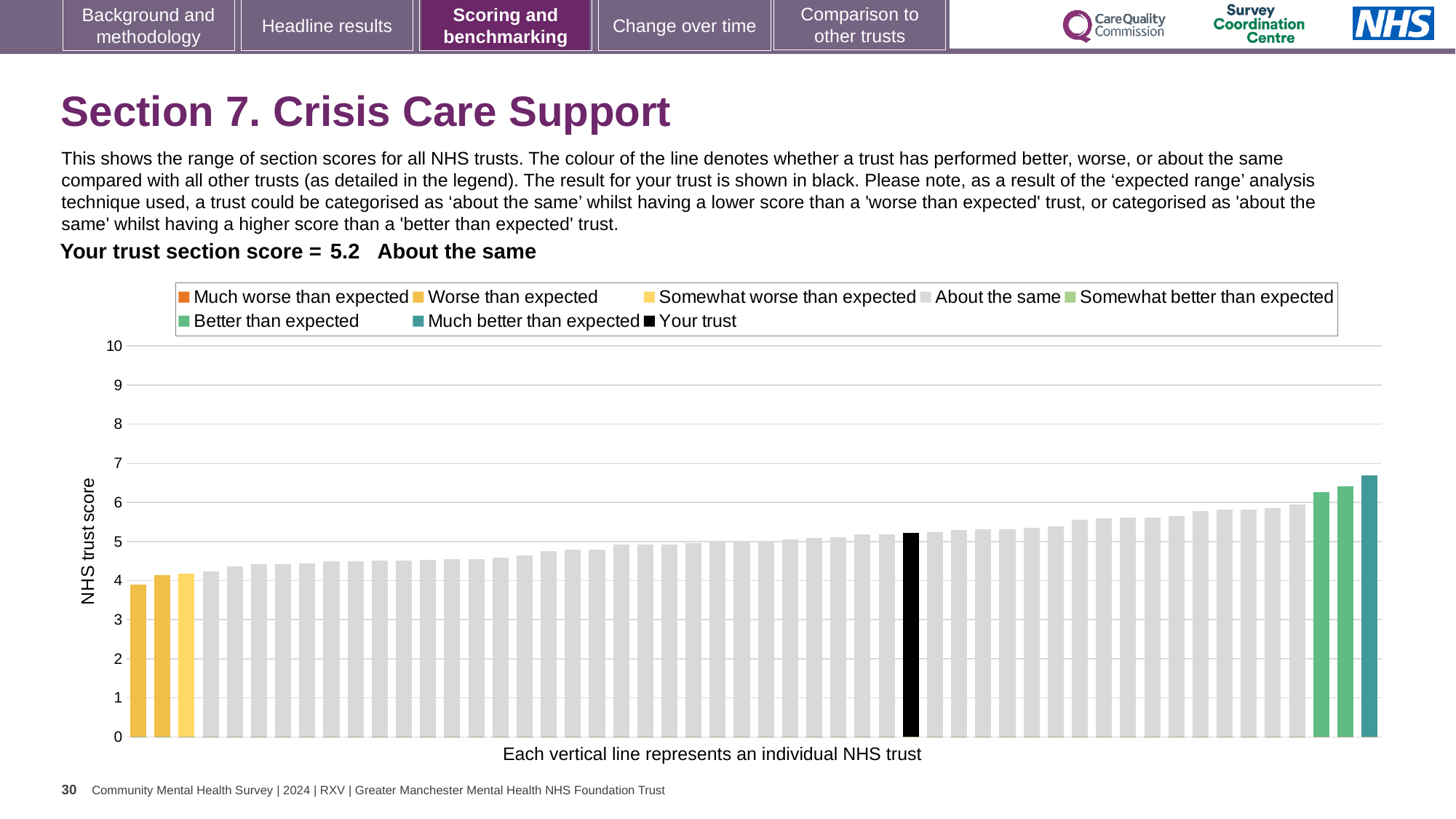
Is the value of the highest bar greater or less than 6? greater What is the section score for your trust shown on the slide? 5.2 How many bars are coloured black for your trust? 1 How many entries does the legend list? 8 What is the title of the vertical axis? NHS trust score Is the value of the lowest bar greater or less than 5? less What kind of chart is shown on the slide? bar chart Which category is your trust placed in for this section? About the same Is the value for your trust greater or less than 5? greater Which legend category does the highest bar belong to? Much better than expected Do the bar values rise or fall from left to right along the x axis? rise